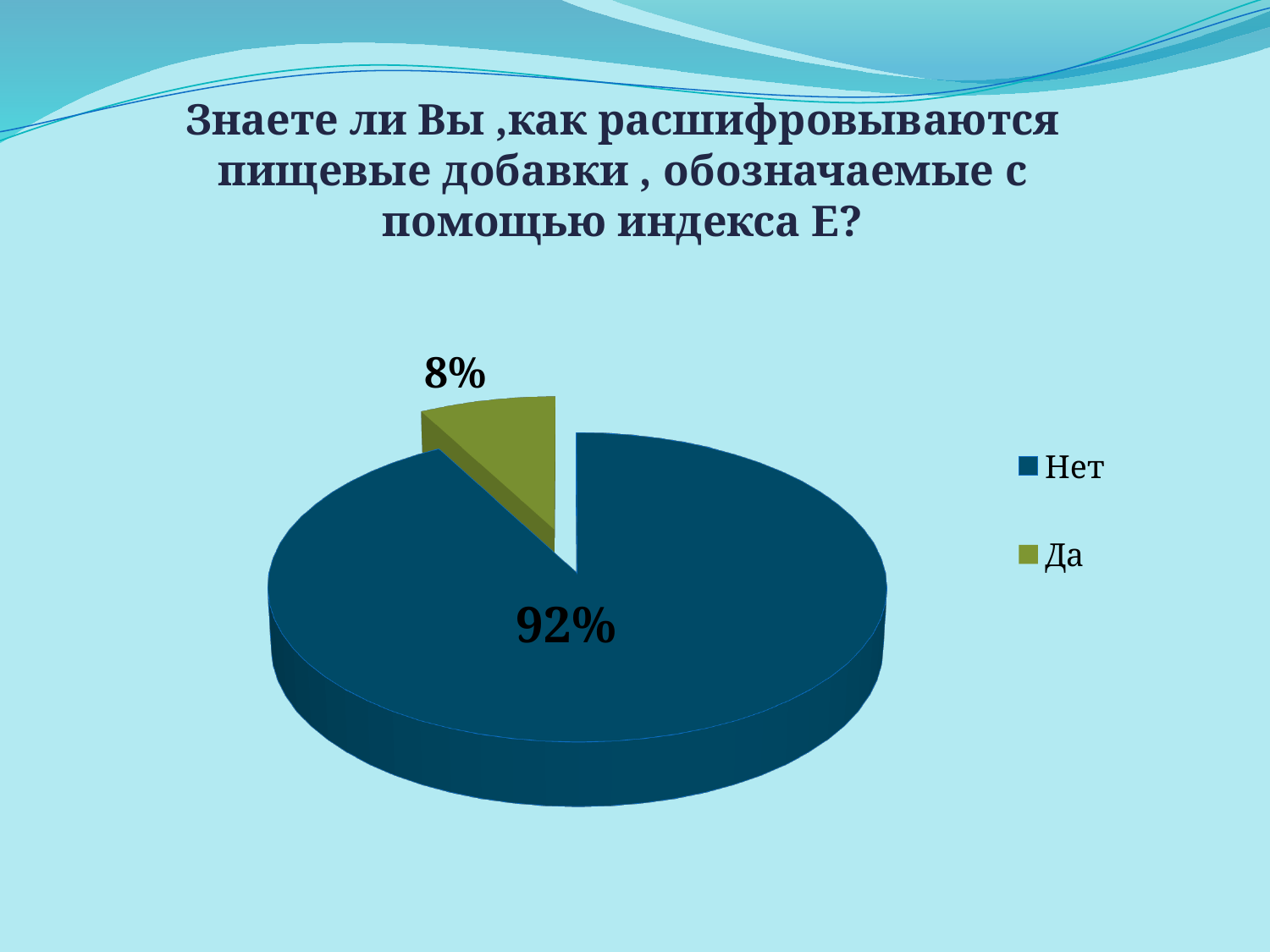
What percentage of respondents answered "Да"? 8% Which answer has the smallest share of the pie? Да What colour is the "Да" slice? green Which slice is larger, "Да" or "Нет"? Нет What kind of chart is shown on the slide? pie chart What percentage of respondents answered "Нет"? 92% How many entries does the legend list? 2 What share of the pie does the "Да" slice represent? 8% Which answer has the largest share of the pie? Нет How many slices does the pie chart have? 2 What is the difference in percentage points between the "Нет" and "Да" slices? 84 Which legend entry is listed first? Нет